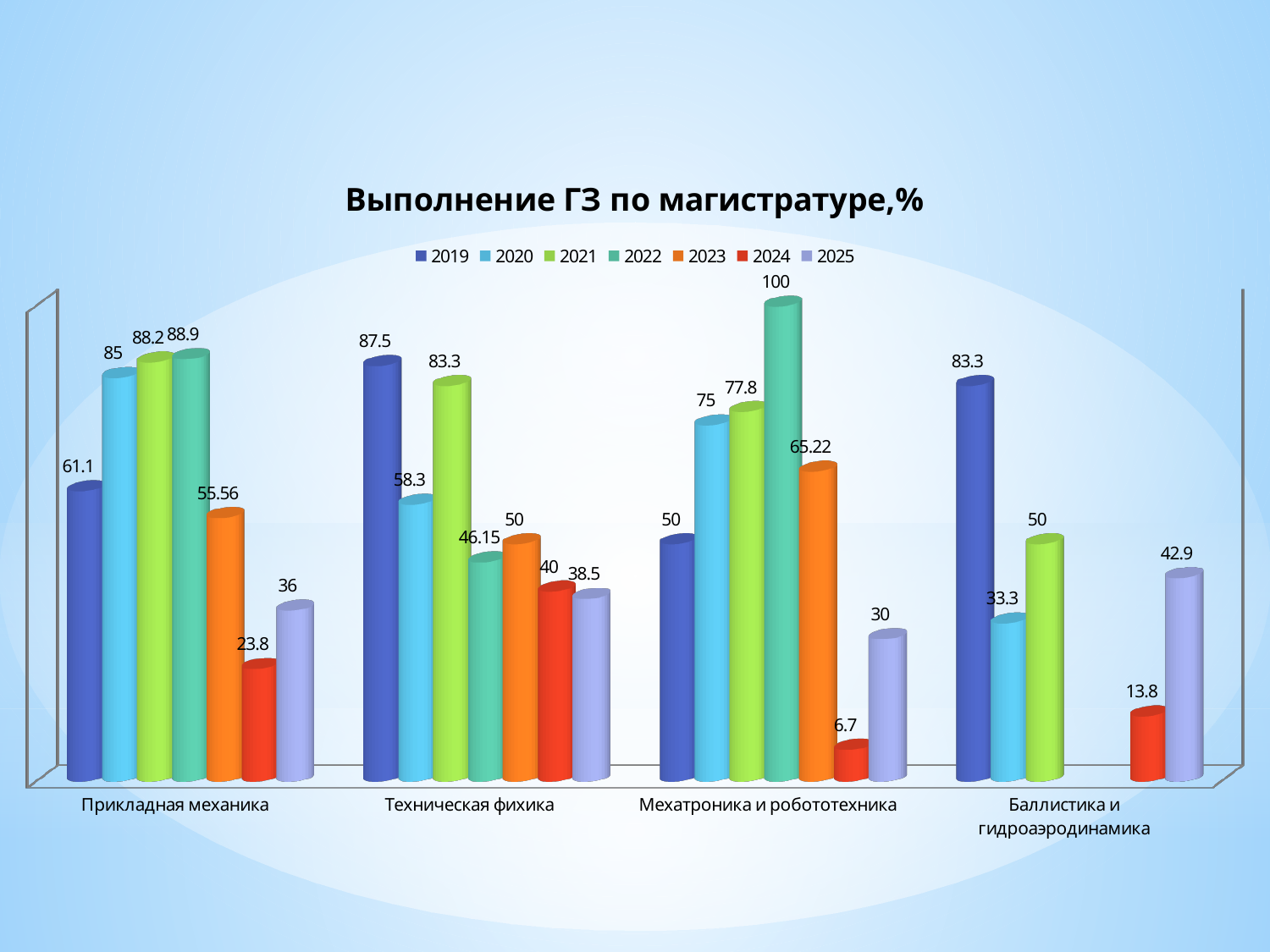
How many series does the legend list? 7 What is the value for 2024 in the Прикладная механика category? 23.8 What is the value for 2022 in the Мехатроника и робототехника category? 100 How many categories are shown on the x axis? 4 Which is larger in the Баллистика и гидроаэродинамика category: the 2020 value or the 2025 value? 2025 What is the value for 2023 in the Техническая фихика category? 50 What is the difference between the 2020 and 2019 values in the Прикладная механика category? 23.9 What is the value for 2025 in the Баллистика и гидроаэродинамика category? 42.9 What kind of chart is shown on the slide? Bar chart Which year has the lowest value in the Мехатроника и робототехника category? 2024 What is the title of the chart? Выполнение ГЗ по магистратуре,% Which year has the highest value in the Техническая фихика category? 2019